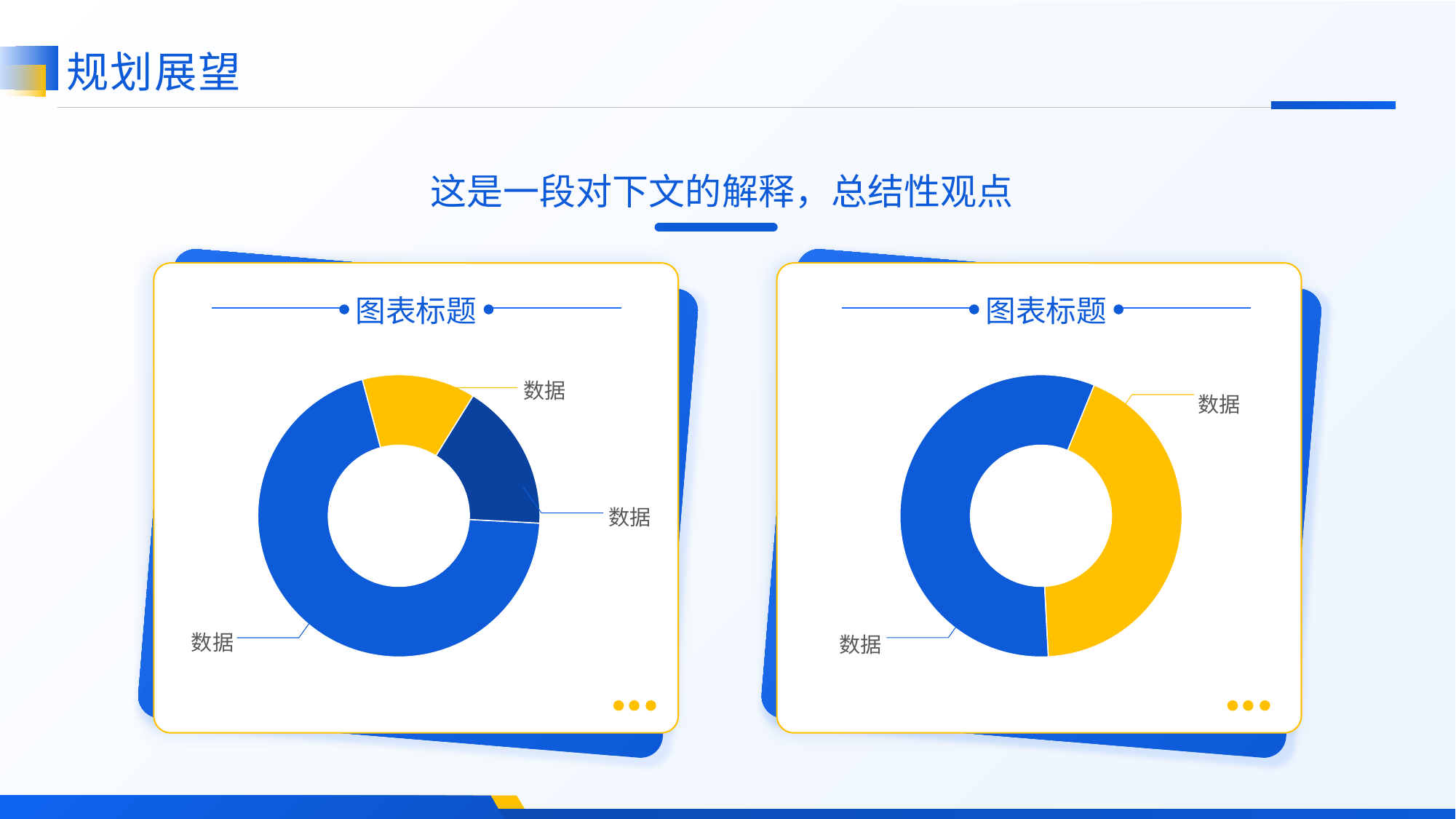
What kind of chart is shown on the left side of the slide? Donut chart What is the title of the left chart? 图表标题 What colours are used for the slices in the right donut chart? Blue and yellow In the left donut chart, which colour slice is the largest? Blue How many slices does the left donut chart have? 3 What kind of chart is shown on the right side of the slide? Donut chart In the right donut chart, which colour slice is larger, blue or yellow? Blue How many slices does the right donut chart have? 2